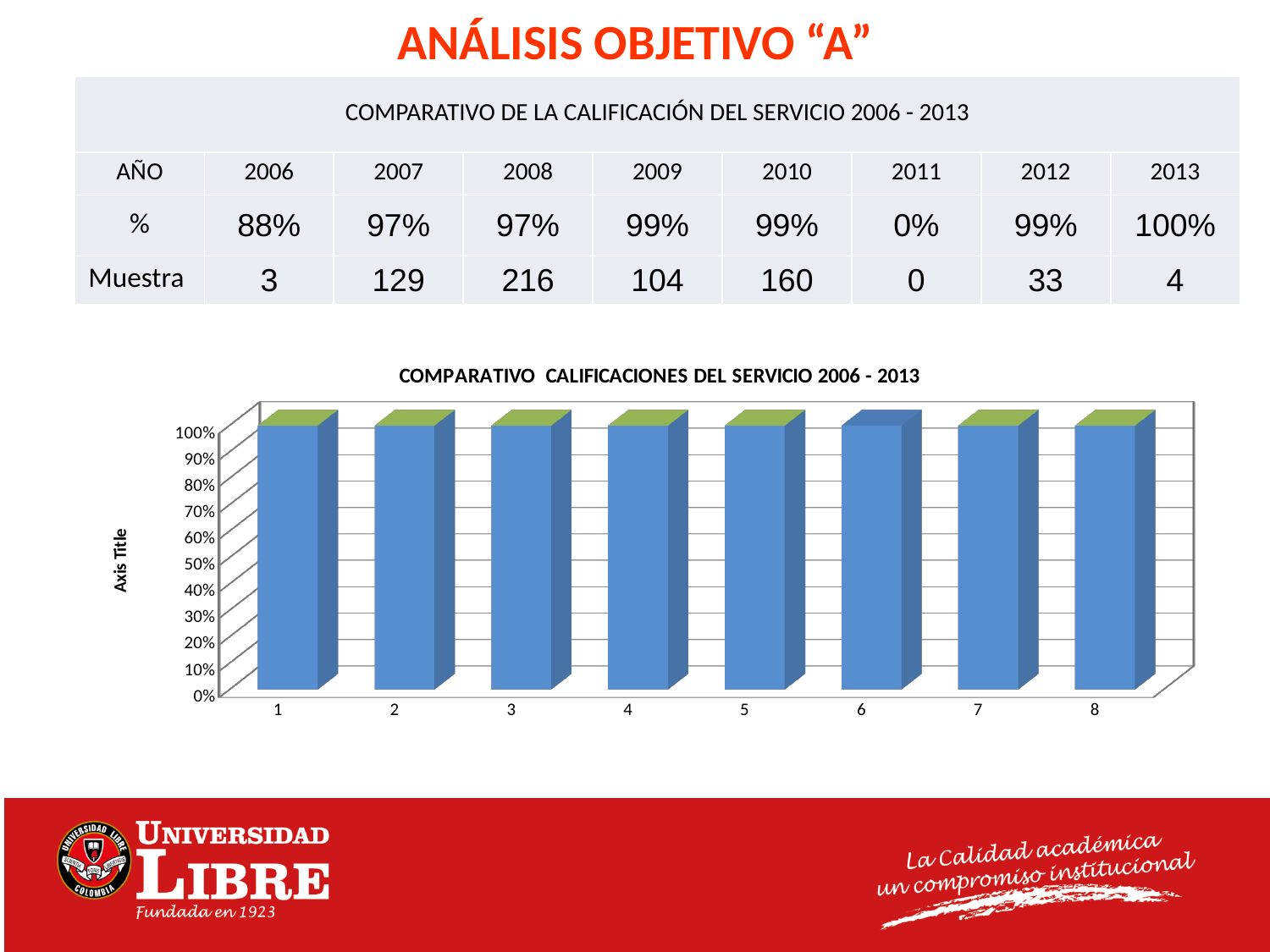
What is the label of the first category on the horizontal axis? 1 Is the total height of the bar for category 5 greater or less than 80%? greater How many bars (categories) are plotted in the chart? 8 What kind of chart is shown on the slide? Bar chart What is the label shown on the vertical axis of the chart? Axis Title What is the title of the chart? COMPARATIVO CALIFICACIONES DEL SERVICIO 2006 - 2013 Do the total bar heights rise, fall, or stay flat across categories 1 to 8? Stay flat Which category's bar has no green segment on top? 6 What is the highest percentage tick shown on the vertical axis? 100% Is the total height of the bar for category 8 greater or less than 90%? greater What is the total height of the stacked bar for category 3, as read from the axis? 100% Is the total height of the bar for category 1 greater or less than 50%? greater